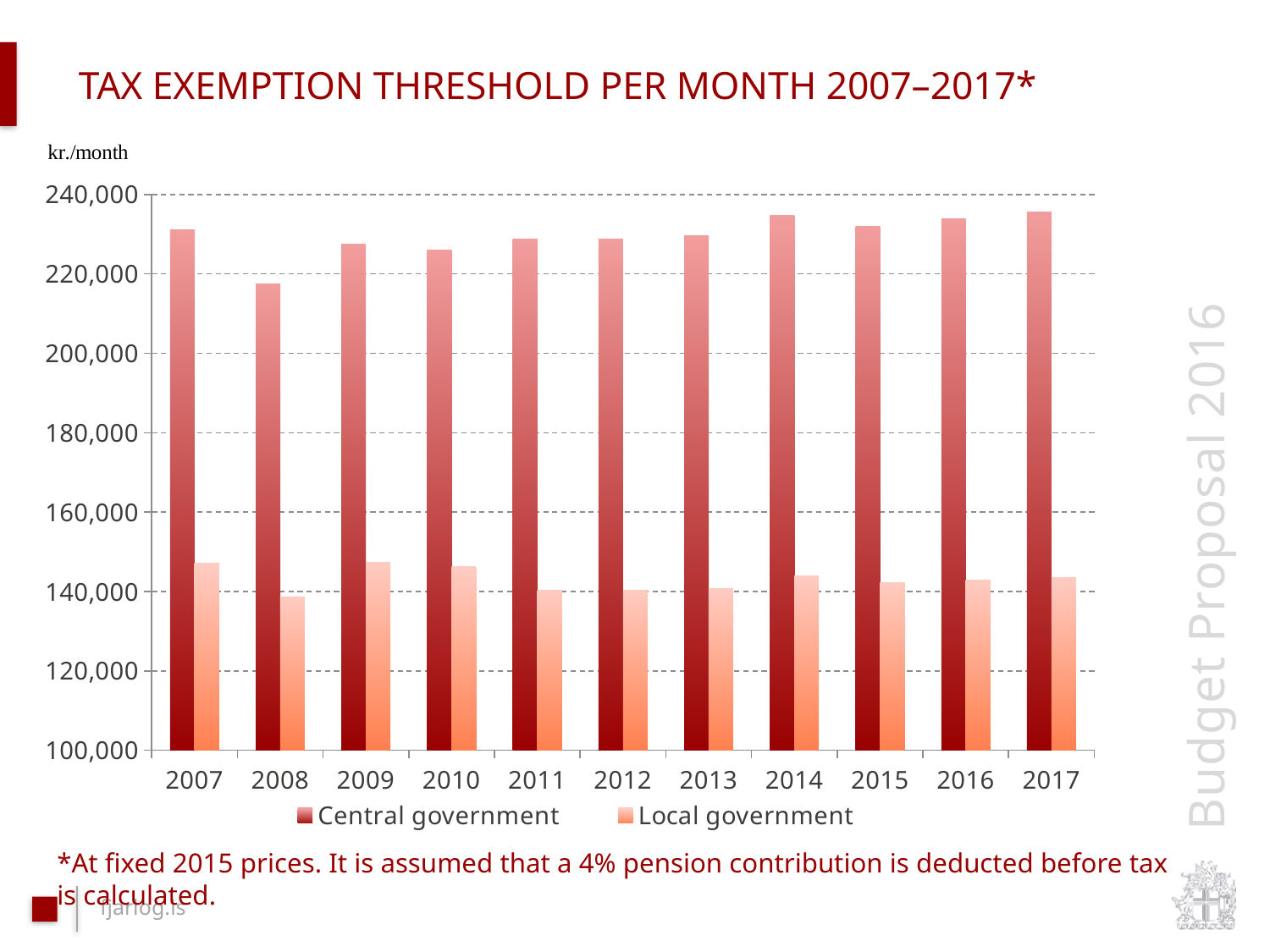
Is the Central government value for 2017 greater or less than 240,000? less Which is larger, the Central government value for 2007 or for 2008? 2007 How many years are shown on the x axis? 11 Which year has the lowest Central government tax exemption threshold? 2008 What kind of chart is shown on the slide? bar chart What unit is shown on the y axis of the chart? kr./month Is the Central government value for 2008 greater or less than 220,000? less Is the Local government value for 2007 greater or less than 140,000? greater Which year has the lowest Local government tax exemption threshold? 2008 Does the Central government threshold rise or fall from 2007 to 2008? fall How many series does the legend list? 2